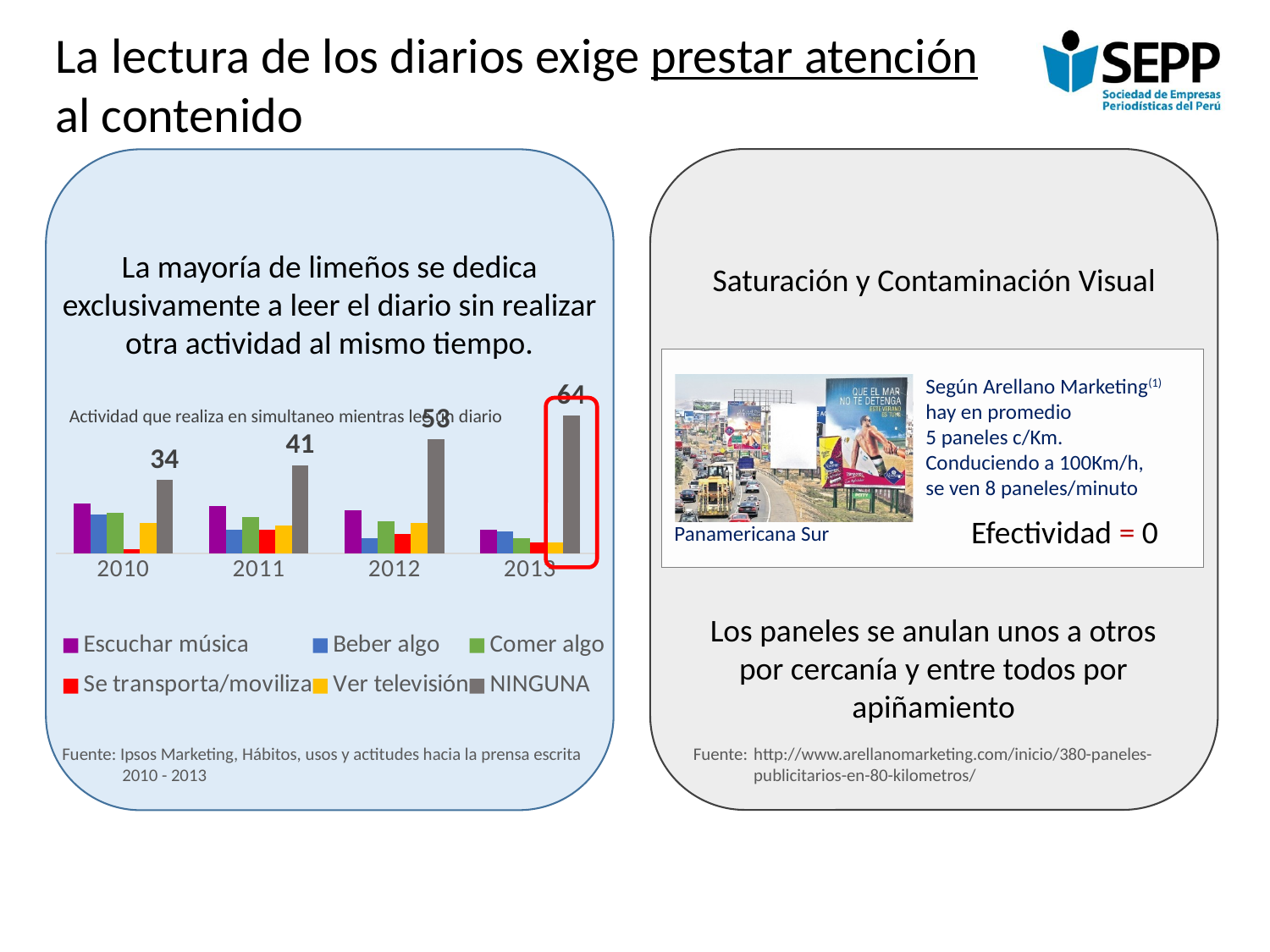
What kind of chart is 'Actividad que realiza en simultaneo mientras lee un diario'? bar chart How many years are shown on the x axis of the chart 'Actividad que realiza en simultaneo mientras lee un diario'? 4 In the chart 'Actividad que realiza en simultaneo mientras lee un diario', which year has the lowest NINGUNA value? 2010 In the chart 'Actividad que realiza en simultaneo mientras lee un diario', what is the value for NINGUNA in 2011? 41 In the chart 'Actividad que realiza en simultaneo mientras lee un diario', which is larger for NINGUNA: 2011 or 2013? 2013 In the chart 'Actividad que realiza en simultaneo mientras lee un diario', what is the difference between the NINGUNA values for 2013 and 2010? 30 In the chart 'Actividad que realiza en simultaneo mientras lee un diario', what is the value for NINGUNA in 2013? 64 In the chart 'Actividad que realiza en simultaneo mientras lee un diario', what is the value for NINGUNA in 2010? 34 How many series does the legend of the chart 'Actividad que realiza en simultaneo mientras lee un diario' list? 6 In the chart 'Actividad que realiza en simultaneo mientras lee un diario', which year has the highest NINGUNA value? 2013 In the chart 'Actividad que realiza en simultaneo mientras lee un diario', do the NINGUNA values rise or fall from 2010 to 2013? rise In the chart 'Actividad que realiza en simultaneo mientras lee un diario', which series is shown in grey? NINGUNA